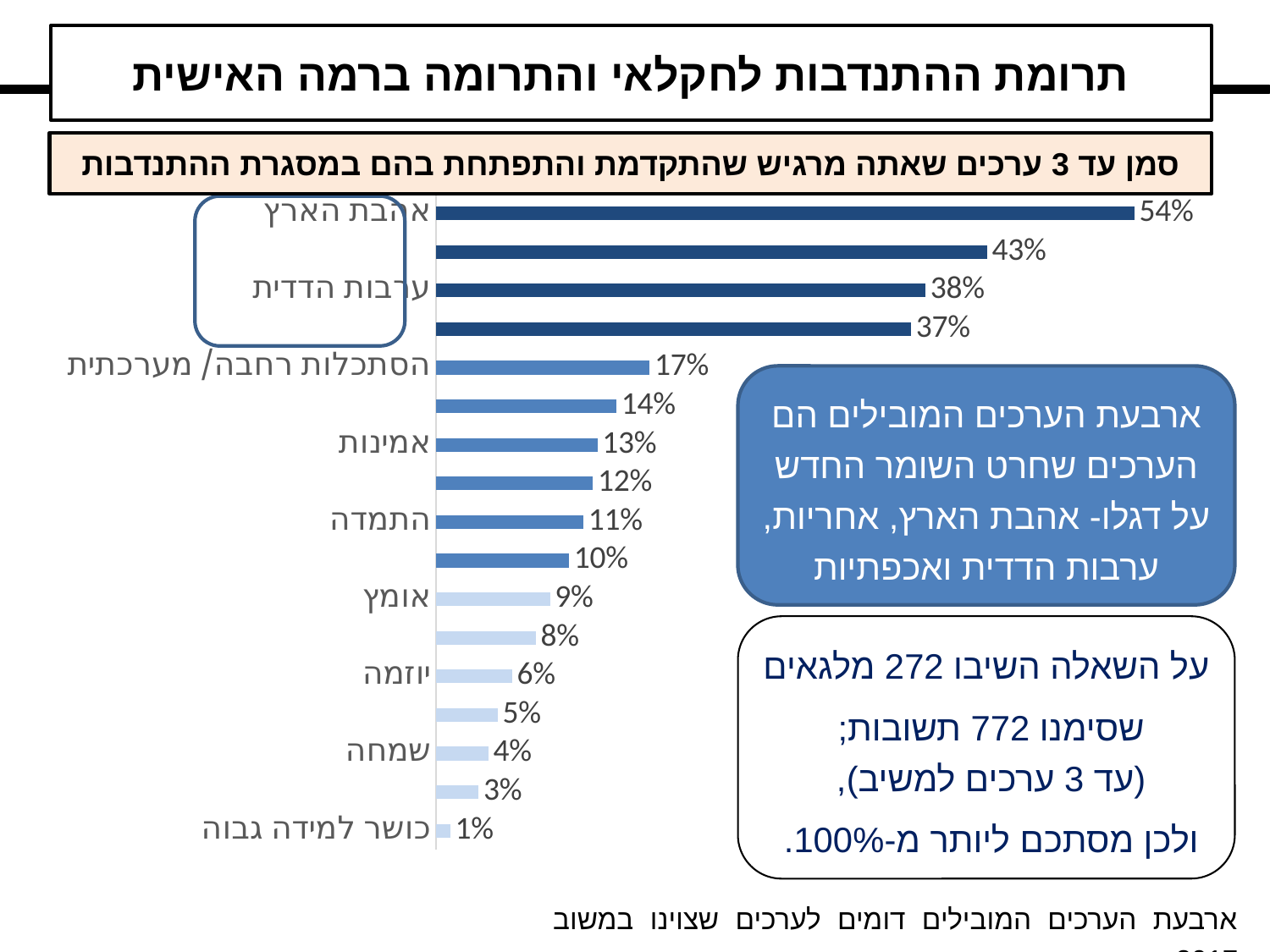
What is the difference between the values for אהבת הארץ and ערבות הדדית? 16% What value is shown for כושר למידה גבוה? 1% What value is shown for ערבות הדדית? 38% Which is larger, the value for התמדה or the value for אומץ? התמדה What kind of chart is shown on the slide? Bar chart Which category has the lowest value? כושר למידה גבוה What value is shown for אהבת הארץ? 54% How many bars are plotted in the chart? 17 Do the values rise or fall going from the top bar to the bottom bar? Fall Which category has the highest value? אהבת הארץ What value is shown for הסתכלות רחבה/ מערכתית? 17% What value is shown for אמינות? 13%